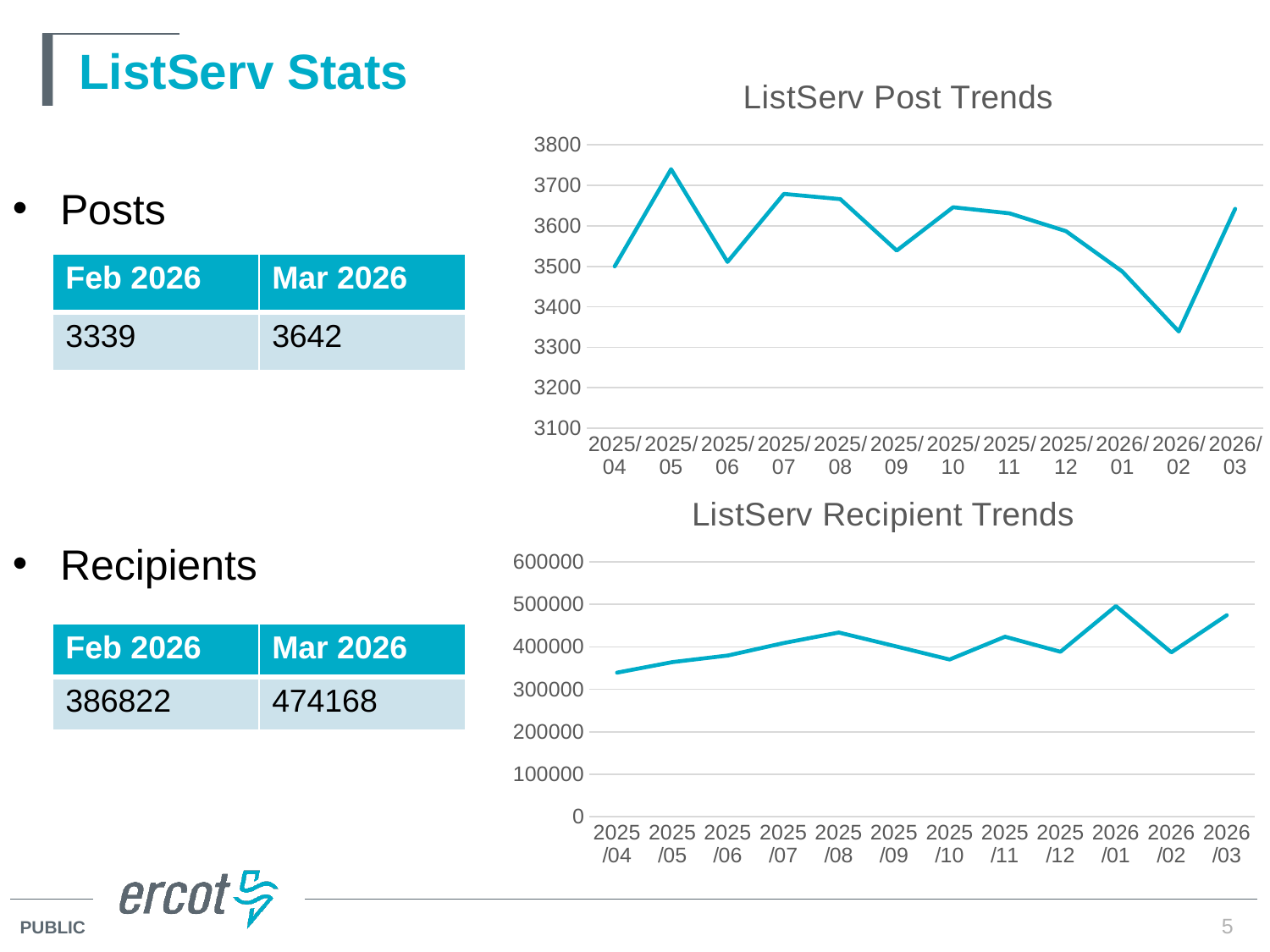
On the ListServ Post Trends chart, do the values rise or fall from 2025/10 to 2026/02? fall According to the Recipients table on the slide, what is the difference between the Mar 2026 and Feb 2026 recipient counts? 87346 On the ListServ Post Trends chart, is the value for 2025/05 greater or less than 3700? greater On the ListServ Post Trends chart, which month has the lowest number of posts? 2026/02 On the ListServ Recipient Trends chart, which month has the highest number of recipients? 2026/01 On the ListServ Recipient Trends chart, which is larger, the value for 2026/02 or 2026/03? 2026/03 What kind of chart is the ListServ Post Trends chart? line chart How many months are plotted on the ListServ Post Trends chart? 12 On the ListServ Post Trends chart, is the value for 2026/02 greater or less than 3400? less On the ListServ Recipient Trends chart, is the value for 2025/10 greater or less than 400000? less On the ListServ Post Trends chart, which month has the highest number of posts? 2025/05 On the ListServ Recipient Trends chart, which month has the lowest number of recipients? 2025/04